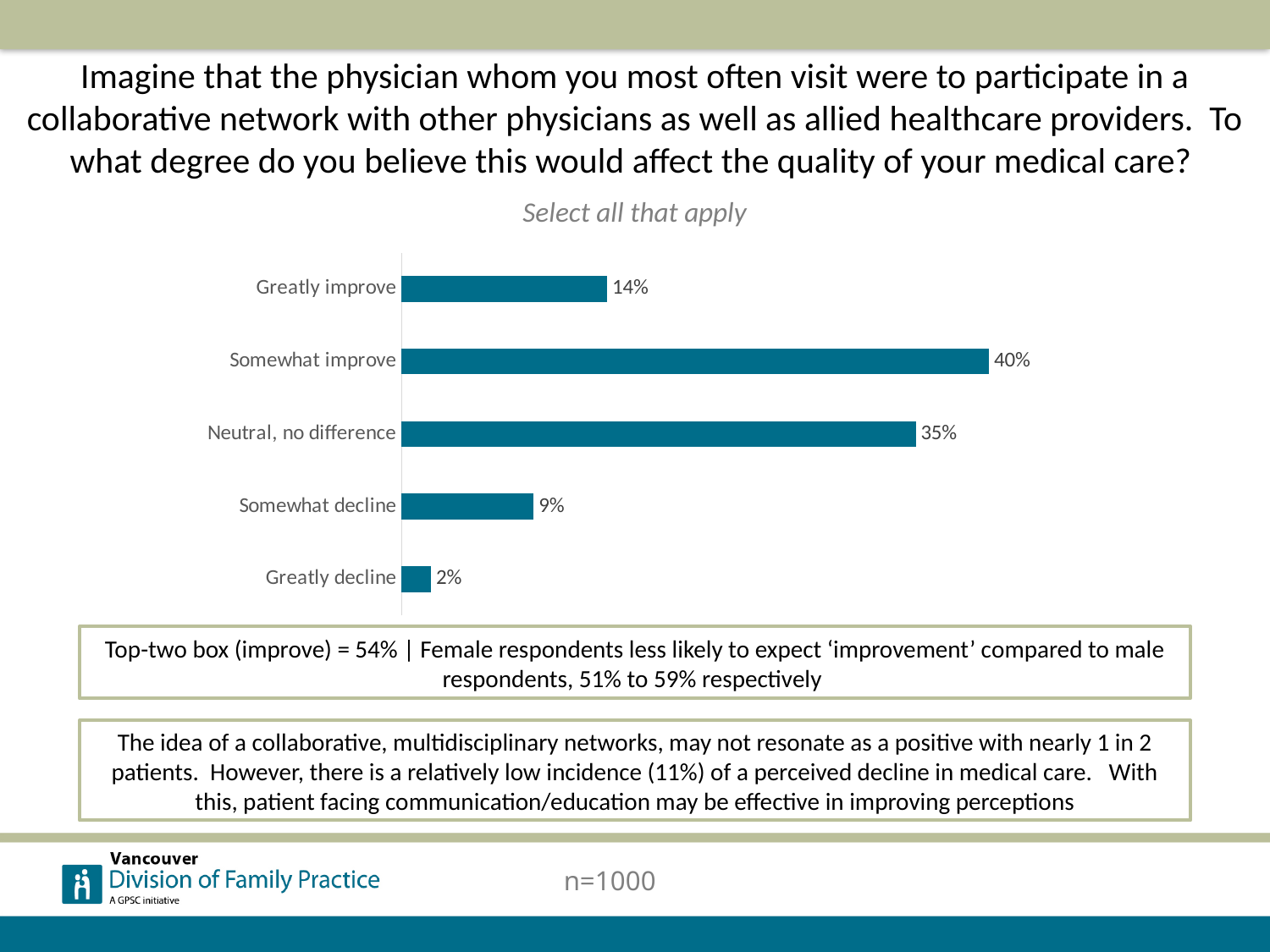
How many categories are shown in the chart? 5 What is the difference between the values for 'Somewhat improve' and 'Neutral, no difference'? 5% What kind of chart is shown on the slide? Bar chart What is the difference between the values for 'Greatly improve' and 'Somewhat decline'? 5% What is the combined value of 'Greatly improve' and 'Somewhat improve'? 54% What is the value shown for 'Greatly decline'? 2% Which is larger, the value for 'Greatly improve' or the value for 'Somewhat decline'? Greatly improve Which category has the highest value in the chart? Somewhat improve What is the subtitle shown above the chart? Select all that apply What percentage of respondents chose 'Neutral, no difference'? 35% What percentage of respondents selected 'Somewhat improve'? 40% Which category has the lowest value in the chart? Greatly decline